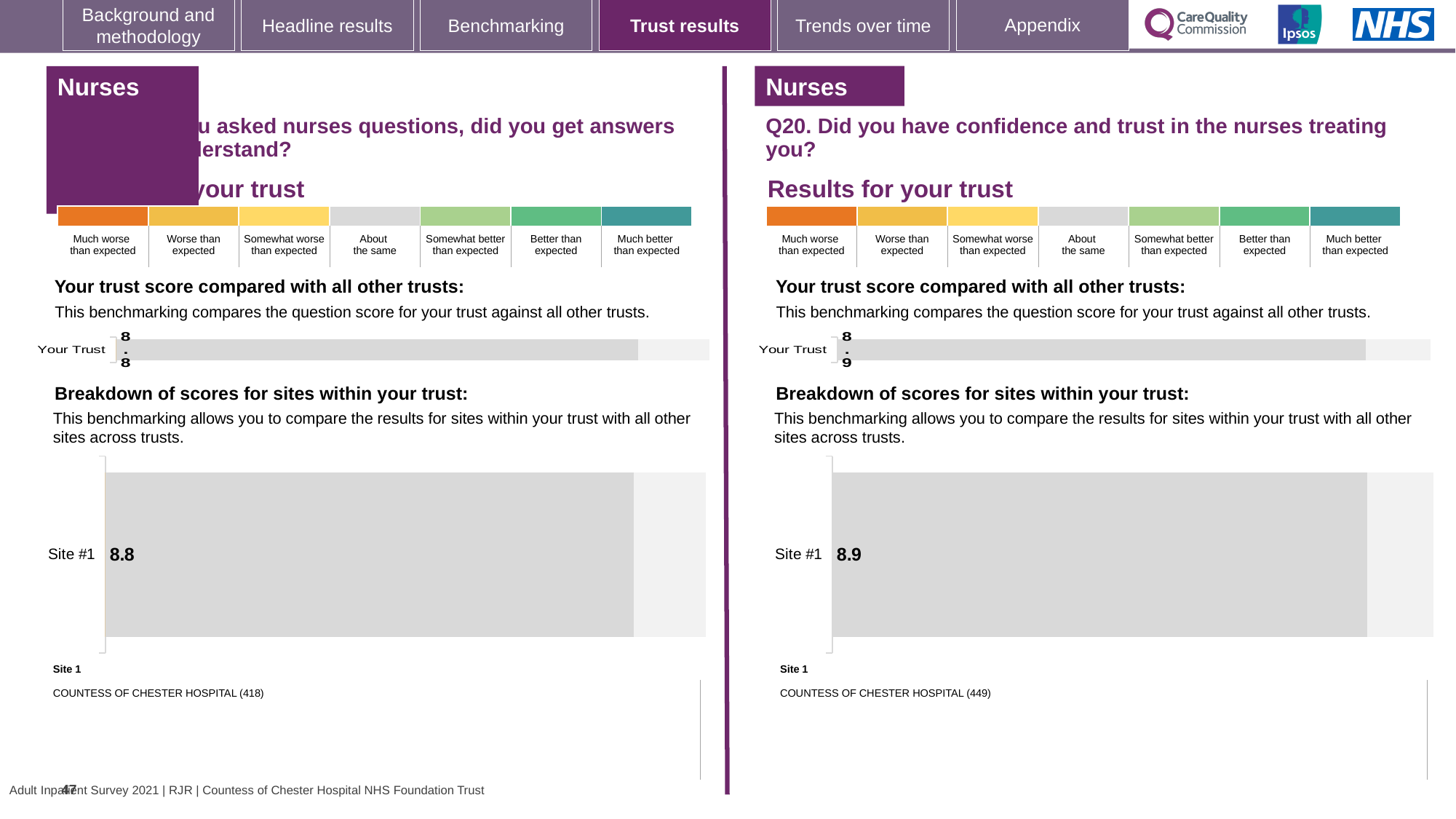
On the right half of the slide (Q20), what is the score shown for Your Trust in the 'Your trust score compared with all other trusts' chart? 8.9 On the right half of the slide (Q20), is the Your Trust score the same as the Site #1 score? Yes What is the difference between the Site #1 score on the right half of the slide (Q20) and the Site #1 score on the left half? 0.1 On the left half of the slide, which hospital is listed as Site 1? COUNTESS OF CHESTER HOSPITAL (418) On the left half of the slide, what score is shown for Site #1 in the 'Breakdown of scores for sites within your trust' chart? 8.8 On the left half of the slide, what is the score shown for Your Trust in the 'Your trust score compared with all other trusts' chart? 8.8 How many sites are shown in the 'Breakdown of scores for sites within your trust' chart on the right half of the slide (Q20)? 1 On the right half of the slide (Q20), which hospital is listed as Site 1? COUNTESS OF CHESTER HOSPITAL (449) What type of chart is used to show the Site #1 score on the left half of the slide? Bar chart On the right half of the slide (Q20), what score is shown for Site #1 in the 'Breakdown of scores for sites within your trust' chart? 8.9 Which is larger: the Site #1 score on the left half of the slide or the Site #1 score on the right half (Q20)? Right half (Q20)